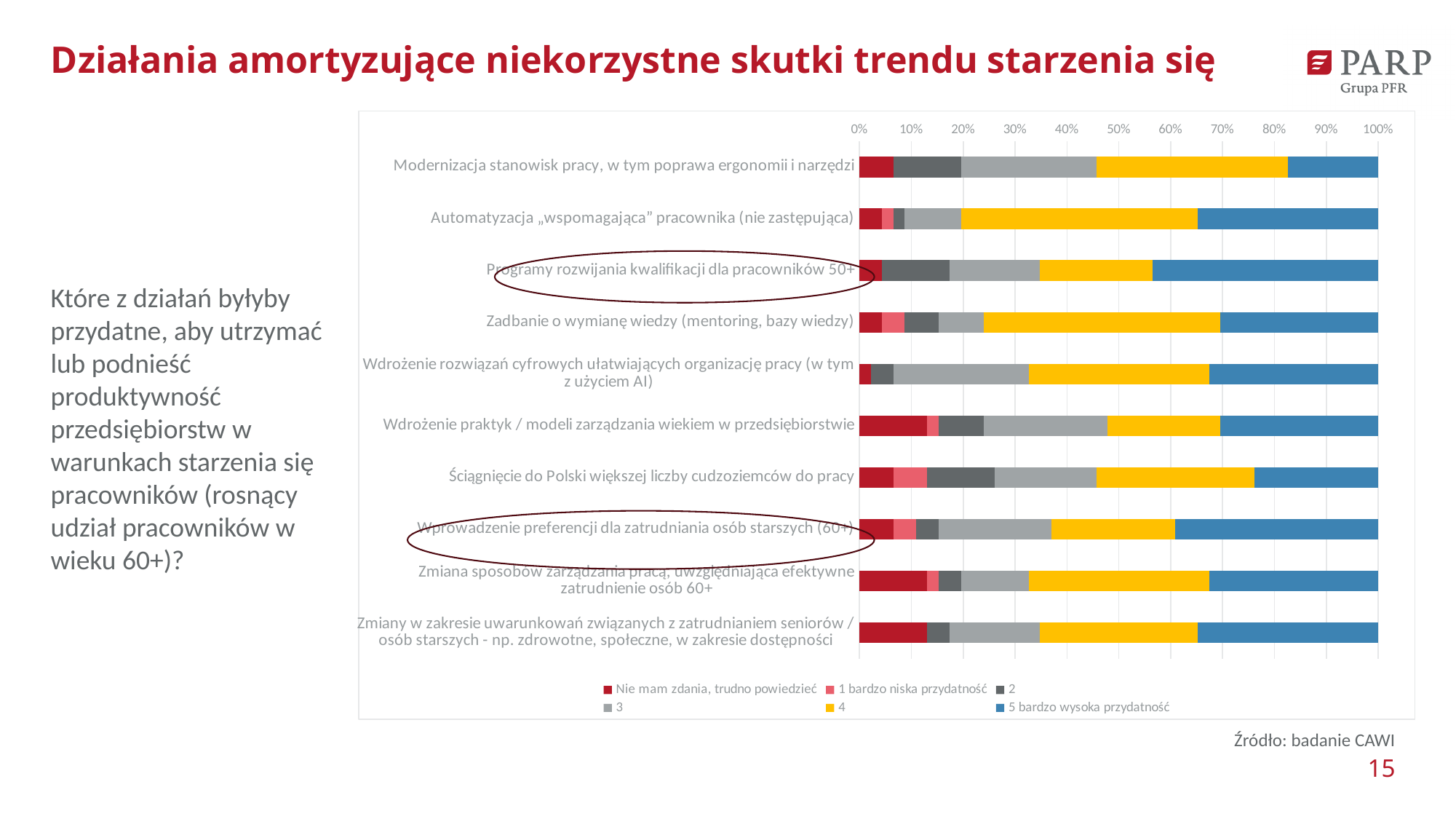
Which category has the smallest share of "5 bardzo wysoka przydatność"? Modernizacja stanowisk pracy, w tym poprawa ergonomii i narzędzi Which has a larger share of "5 bardzo wysoka przydatność": "Programy rozwijania kwalifikacji dla pracowników 50+" or "Modernizacja stanowisk pracy, w tym poprawa ergonomii i narzędzi"? Programy rozwijania kwalifikacji dla pracowników 50+ Is the share of "4" for "Automatyzacja „wspomagająca” pracownika (nie zastępująca)" greater or less than 40%? greater Is the share of "Nie mam zdania, trudno powiedzieć" for "Wdrożenie rozwiązań cyfrowych ułatwiających organizację pracy (w tym z użyciem AI)" greater or less than 10%? less Is the share of "5 bardzo wysoka przydatność" for "Modernizacja stanowisk pracy, w tym poprawa ergonomii i narzędzi" greater or less than 20%? less What kind of chart is shown on the slide? Stacked bar chart Which legend entry is shown in dark red? Nie mam zdania, trudno powiedzieć How many categories (actions) are listed on the chart? 10 Which legend entry is shown in blue? 5 bardzo wysoka przydatność How many series does the chart legend list? 6